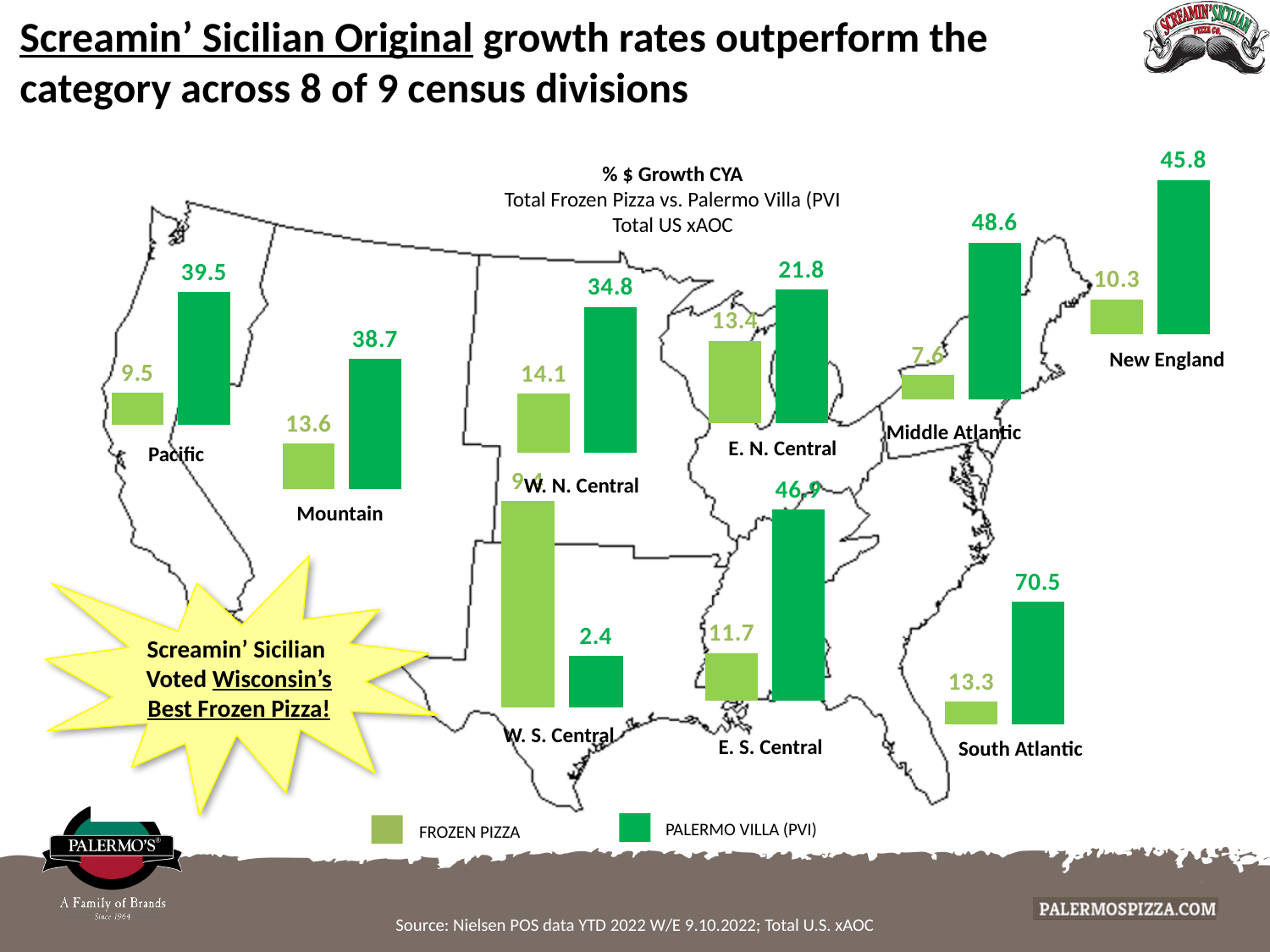
How many series does the legend list? 2 What is the Frozen Pizza value shown for W. N. Central? 14.1 Which series is shown in dark green according to the legend? PALERMO VILLA (PVI) What kind of chart is used to show the growth values on the map? Bar chart What is the Palermo Villa (PVI) value shown for New England? 45.8 Which is larger for E. N. Central, the Frozen Pizza value or the Palermo Villa (PVI) value? Palermo Villa (PVI) What is the Palermo Villa (PVI) % $ growth value shown for South Atlantic? 70.5 What is the difference between the Palermo Villa (PVI) and Frozen Pizza values for Pacific? 30.0 Which census division has the highest Palermo Villa (PVI) growth value? South Atlantic Which census division has the lowest Palermo Villa (PVI) growth value? W. S. Central How many census divisions have bars plotted on the map? 9 What is the Frozen Pizza % $ growth value shown for Middle Atlantic? 7.6